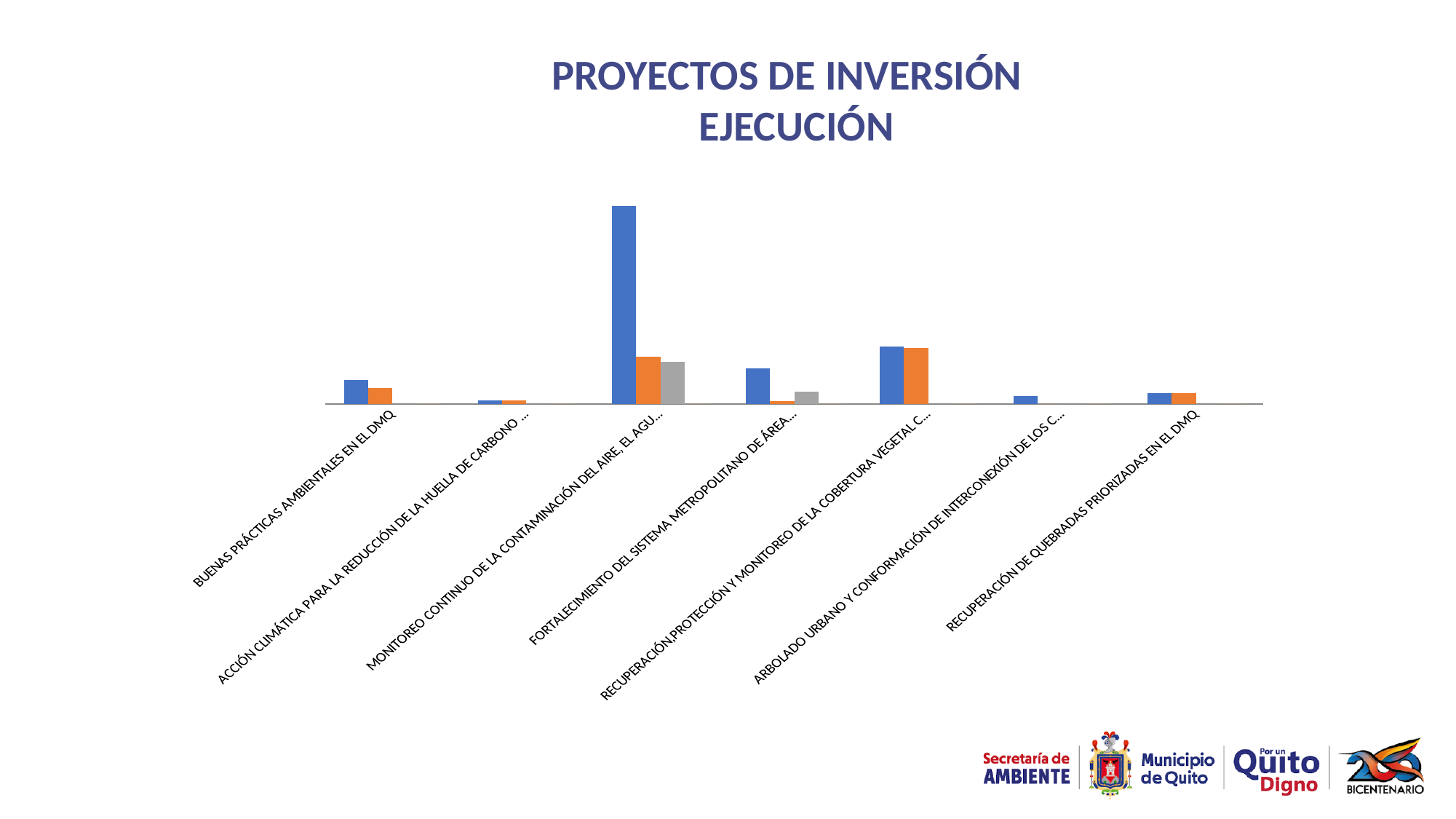
Which category has the tallest blue bar? MONITOREO CONTINUO DE LA CONTAMINACIÓN DEL AIRE, EL AGU... Is the blue bar for BUENAS PRÁCTICAS AMBIENTALES EN EL DMQ taller or shorter than the blue bar for MONITOREO CONTINUO DE LA CONTAMINACIÓN DEL AIRE, EL AGU...? shorter What kind of chart is shown on the slide? bar chart What is the title of the chart? PROYECTOS DE INVERSIÓN EJECUCIÓN How many different bar colours (series) are plotted in the chart? 3 For FORTALECIMIENTO DEL SISTEMA METROPOLITANO DE ÁREA..., is the gray bar or the orange bar taller? gray Which category has the tallest orange bar? RECUPERACIÓN,PROTECCIÓN Y MONITOREO DE LA COBERTURA VEGETAL C... How many categories are shown along the x axis of the chart? 7 Which category has the shortest blue bar? ACCIÓN CLIMÁTICA PARA LA REDUCCIÓN DE LA HUELLA DE CARBONO ... Is the blue bar for ARBOLADO URBANO Y CONFORMACIÓN DE INTERCONEXIÓN DE LOS C... taller or shorter than the blue bar for RECUPERACIÓN DE QUEBRADAS PRIORIZADAS EN EL DMQ? shorter How many categories have a gray bar in the chart? 2